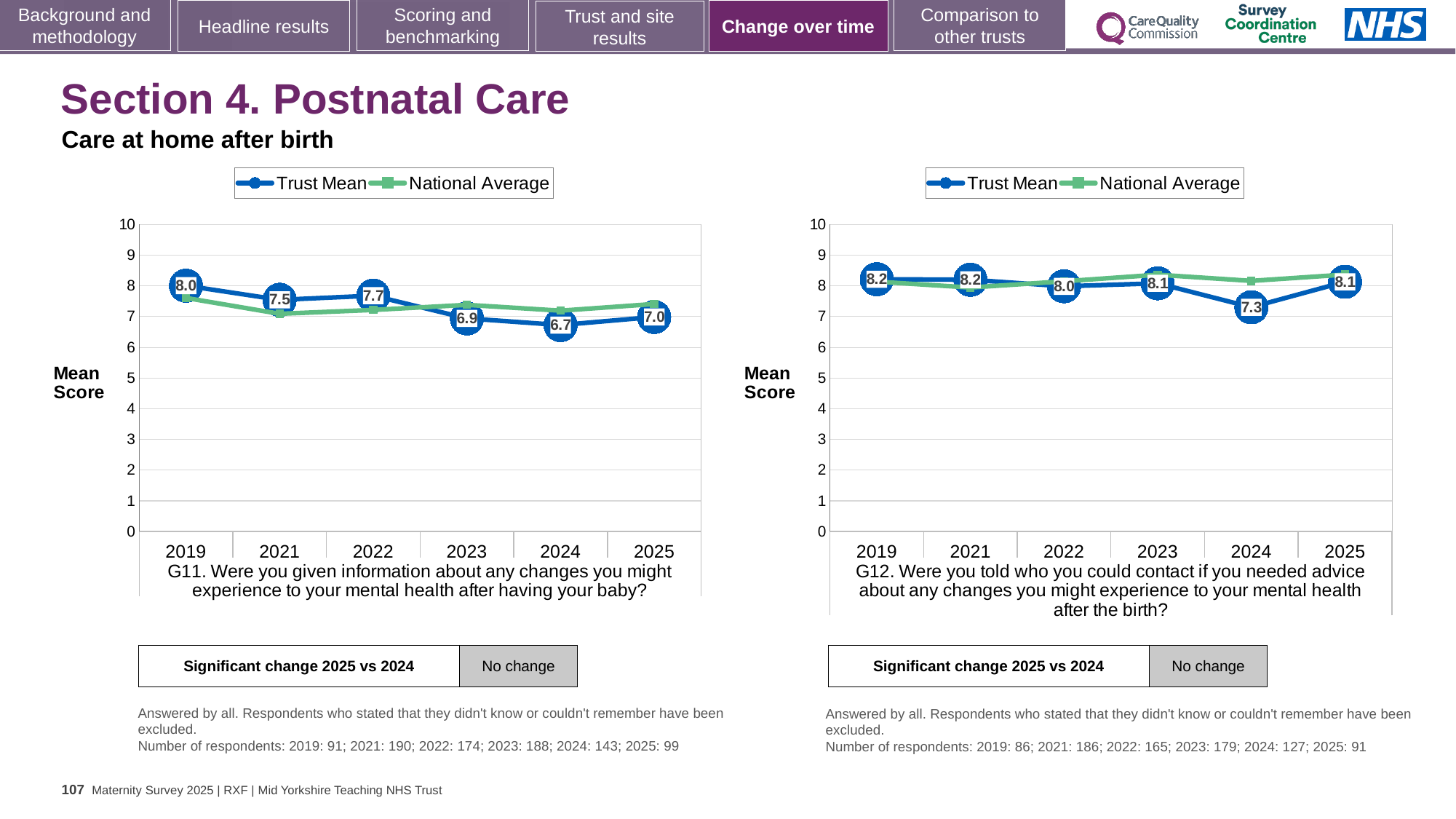
In the G12 chart, which year has the lowest Trust Mean? 2024 In the G12 chart, is the Trust Mean for 2025 larger or smaller than the Trust Mean for 2024? larger In the G11 chart, is the National Average for 2021 greater or less than 8? less How many series does the legend of the G11 chart list? 2 In the G12 chart, what is the Trust Mean for 2024? 7.3 In the G11 chart, which year has the highest Trust Mean? 2019 In the G11 chart, what is the Trust Mean for 2019? 8.0 In the G12 chart, what is the Trust Mean for 2022? 8.0 How many years are plotted on the x axis of the G12 chart? 6 In the G11 chart, which year has the lowest Trust Mean? 2024 In the G11 chart, what is the Trust Mean for 2024? 6.7 In the G11 chart, what is the difference between the Trust Mean for 2019 and 2025? 1.0